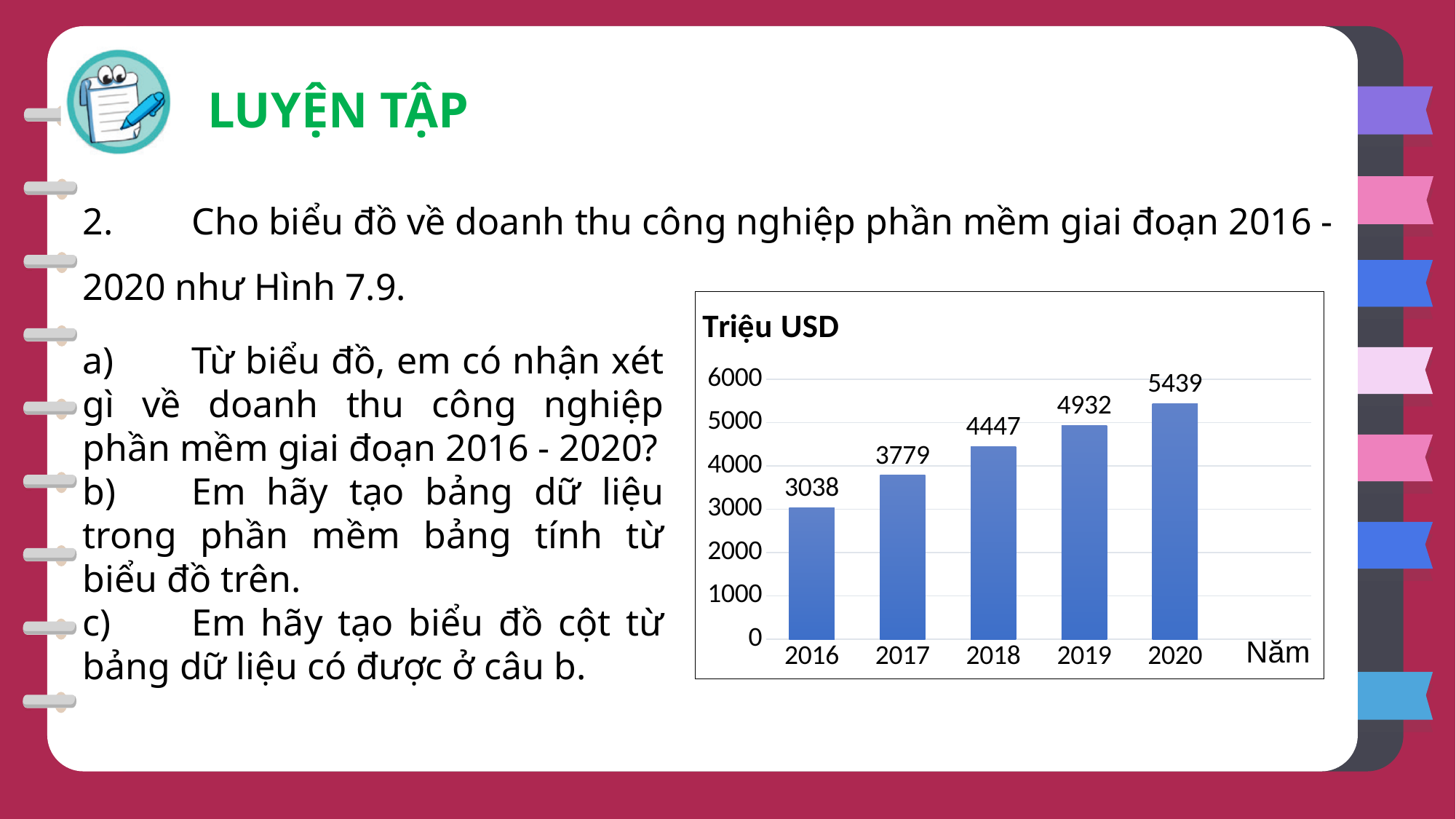
Which year has the lowest value in the chart? 2016 Do the values rise or fall from 2016 to 2020? rise What is the value for 2020 in the chart? 5439 How many years are shown on the x axis of the chart? 5 What is the difference between the values for 2020 and 2016? 2401 What is the value for 2018 in the chart? 4447 Which year has the highest value in the chart? 2020 What kind of chart is shown on the slide? bar chart Which is larger, the value for 2017 or the value for 2019? 2019 Is the value for 2018 greater or less than 4000? greater What is the difference between the values for 2019 and 2017? 1153 What is the value for 2016 in the chart? 3038